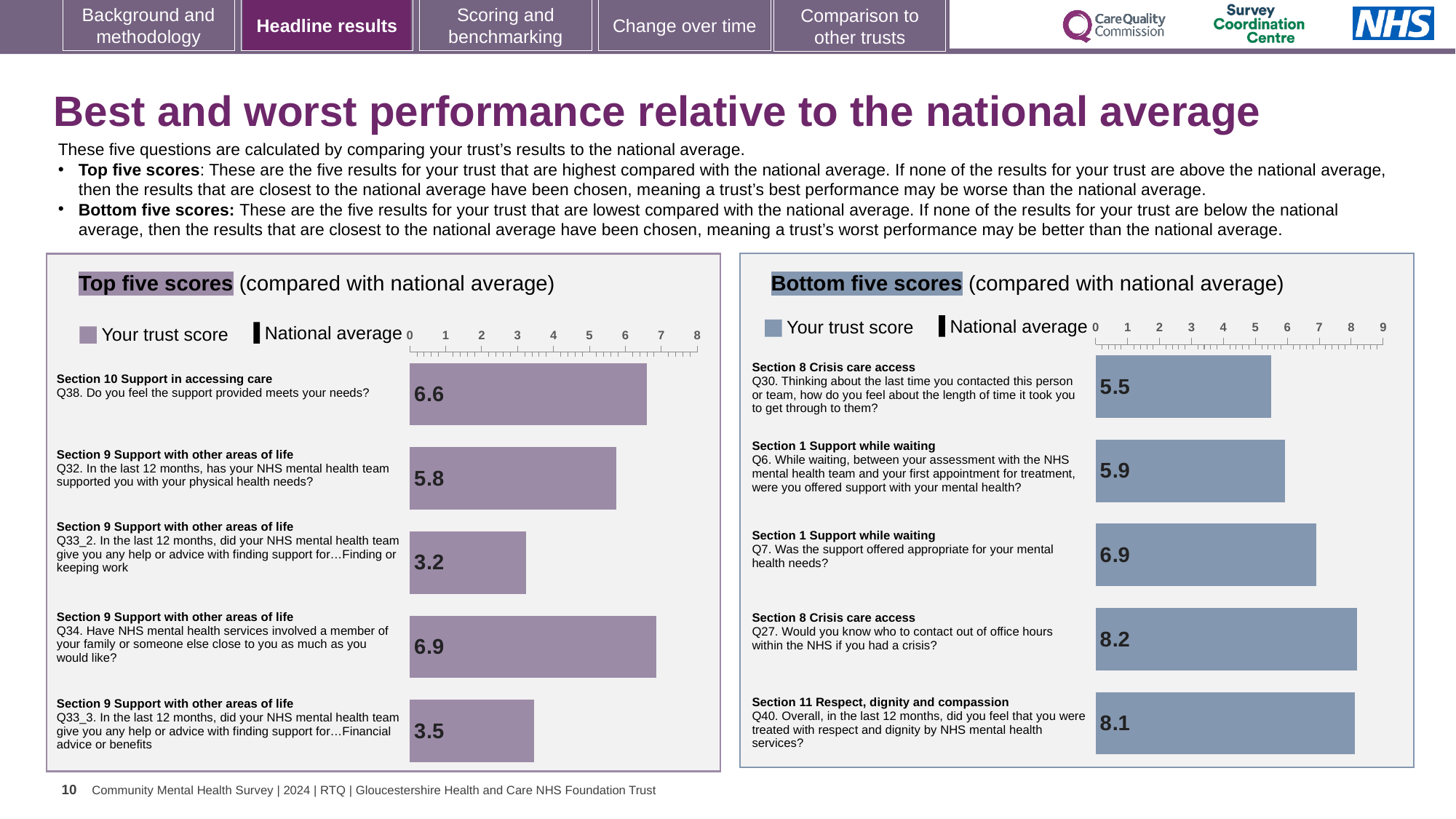
What kind of chart is the Top five scores chart? Bar chart In the Bottom five scores chart, what is the difference between the trust scores for Q40 and Q30? 2.6 In the Top five scores chart, what is the trust score for Q38 (Do you feel the support provided meets your needs)? 6.6 In the Top five scores chart, what is the difference between the trust scores for Q34 and Q33_2? 3.7 In the Bottom five scores chart, what is the trust score for Q27 (Would you know who to contact out of office hours within the NHS if you had a crisis)? 8.2 In the Top five scores chart, which question has the highest trust score? Q34 In the Bottom five scores chart, which is larger, the trust score for Q6 or for Q7? Q7 How many questions are plotted in the Bottom five scores chart? 5 In the Top five scores chart, which question has the lowest trust score? Q33_2 In the Top five scores chart, is the trust score for Q32 greater or less than 5? greater In the Top five scores chart, what is the trust score for Q33_3 (help or advice with finding support for financial advice or benefits)? 3.5 In the Bottom five scores chart, which question has the lowest trust score? Q30